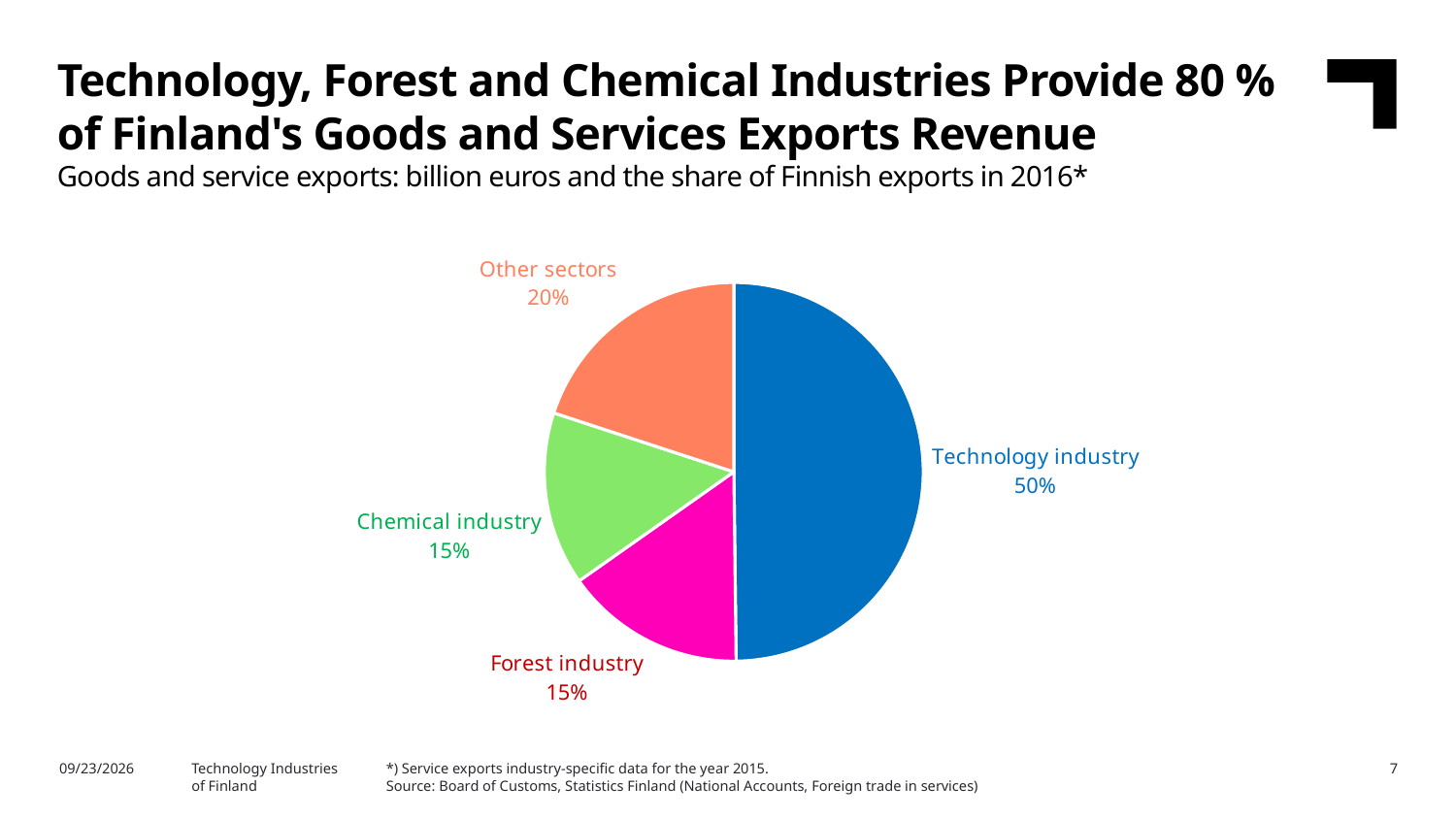
Which sector has the largest share of the pie? Technology industry How many slices does the pie chart have? 4 What share of Finnish exports does the Technology industry account for? 50% What share of Finnish exports does the Chemical industry account for? 15% Which is larger, the share of Other sectors or the share of the Forest industry? Other sectors What share of Finnish exports does the Forest industry account for? 15% What colour is the Technology industry slice? Blue What year does the chart's data refer to, according to the subtitle? 2016 What share of Finnish exports do Other sectors account for? 20% What kind of chart is shown on the slide? Pie chart What is the combined share of the Technology, Forest and Chemical industries? 80% What is the difference in share between the Technology industry and Other sectors? 30 percentage points